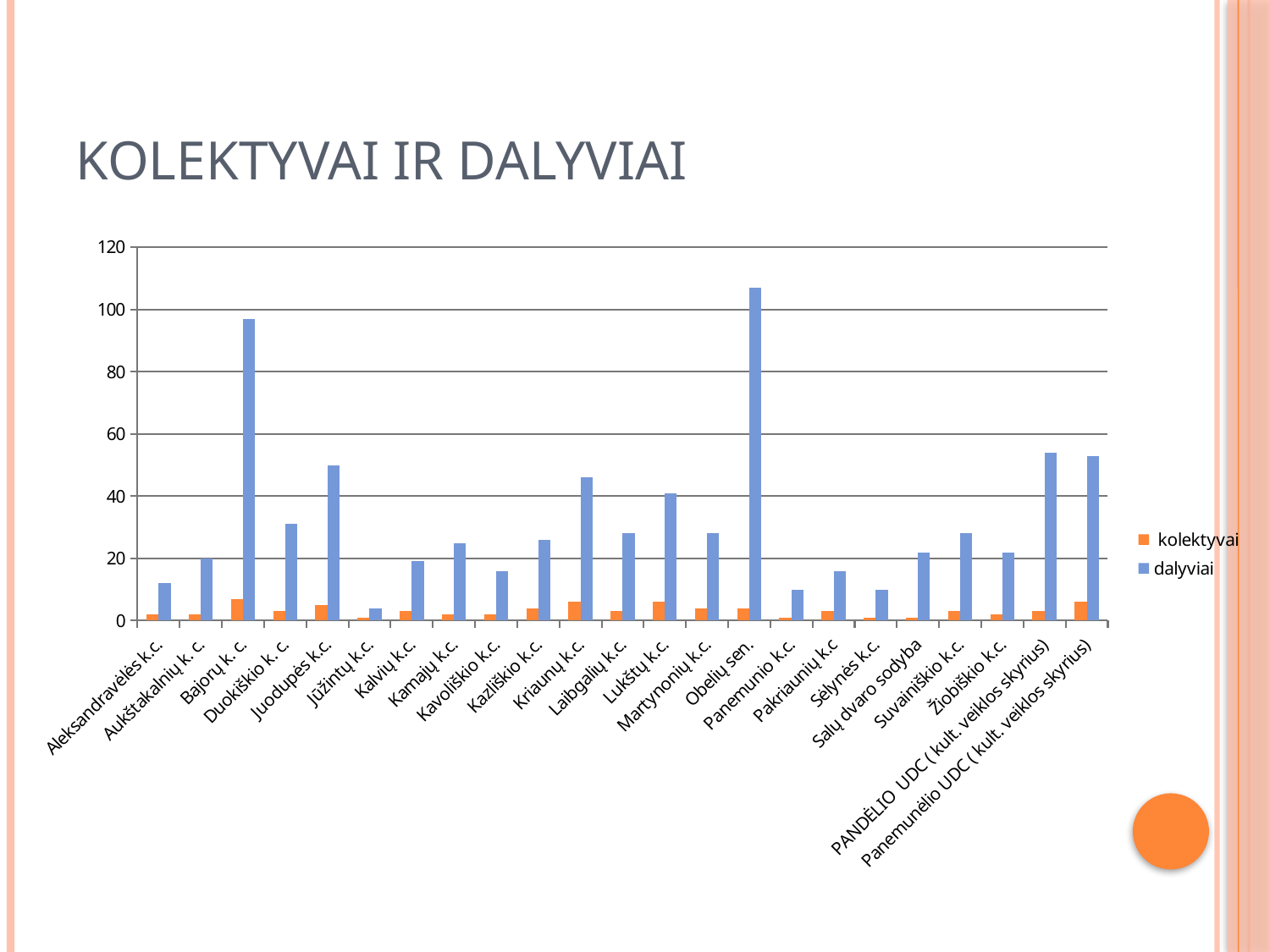
Is the dalyviai value for Kriaunų k.c. greater or less than 40? greater Is the dalyviai value for Jūžintų k.c. greater or less than 20? less What is the title of the chart? KOLEKTYVAI IR DALYVIAI How many categories are shown on the x axis? 23 Which has a larger dalyviai value, Bajorų k.c. or Juodupės k.c.? Bajorų k.c. Is the dalyviai value for Obelių sen. greater or less than 100? greater Which series is shown in blue? dalyviai Which category has the highest dalyviai value? Obelių sen. What kind of chart is shown on the slide? bar chart Which category has the lowest dalyviai value? Jūžintų k.c. How many series does the legend list? 2